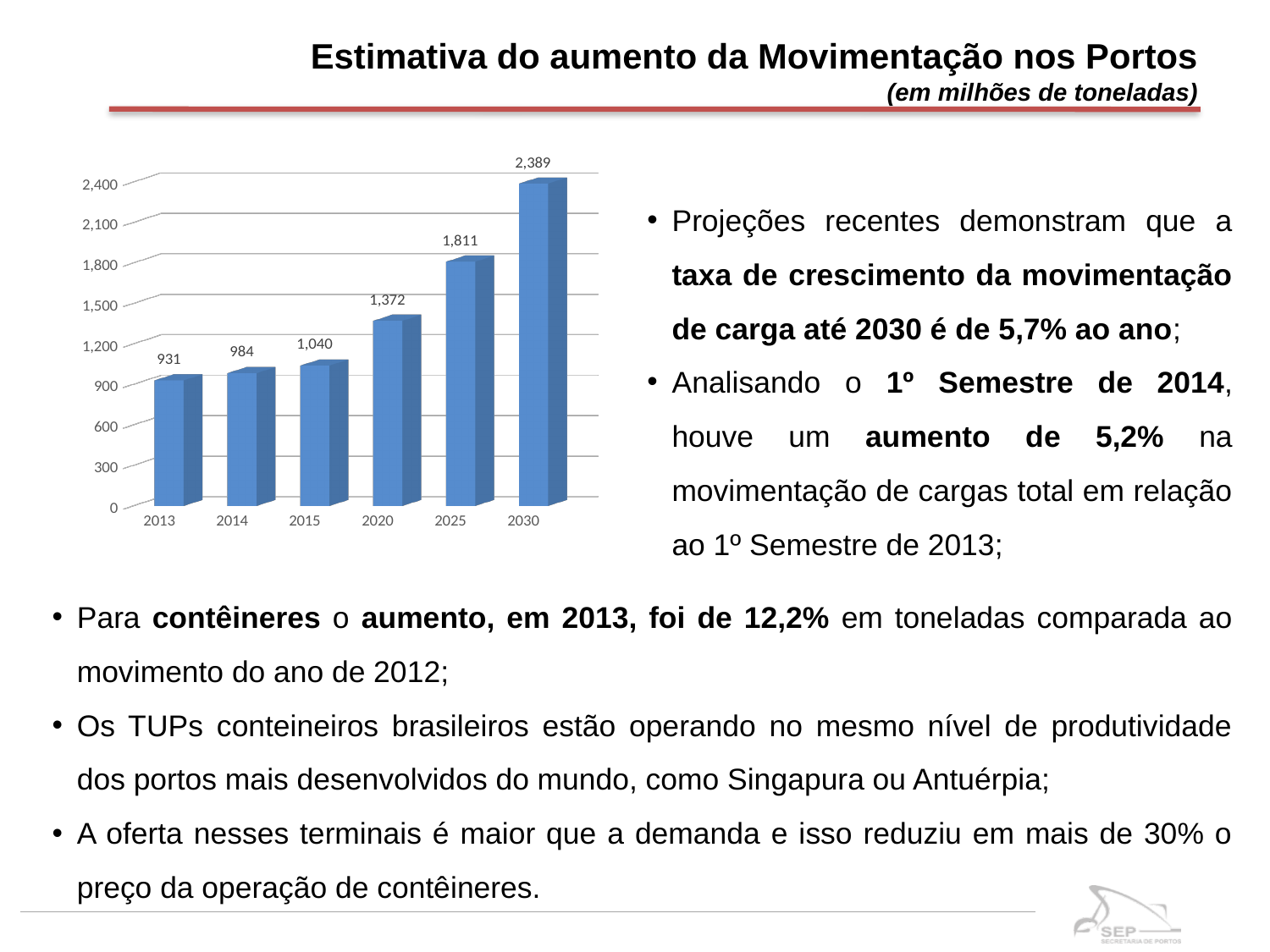
What is the value shown for 2030? 2,389 What is the value shown for 2013? 931 Is the value for 2025 greater or less than 1,500? greater Do the values rise or fall from 2013 to 2030? rise How many years are shown on the x axis? 6 What kind of chart is shown on the slide? bar chart Which year has the highest value? 2030 Which year has the lowest value? 2013 Which is larger, the value for 2020 or the value for 2015? 2020 What is the difference between the values for 2030 and 2025? 578 What is the difference between the values for 2015 and 2014? 56 What is the value shown for 2020? 1,372